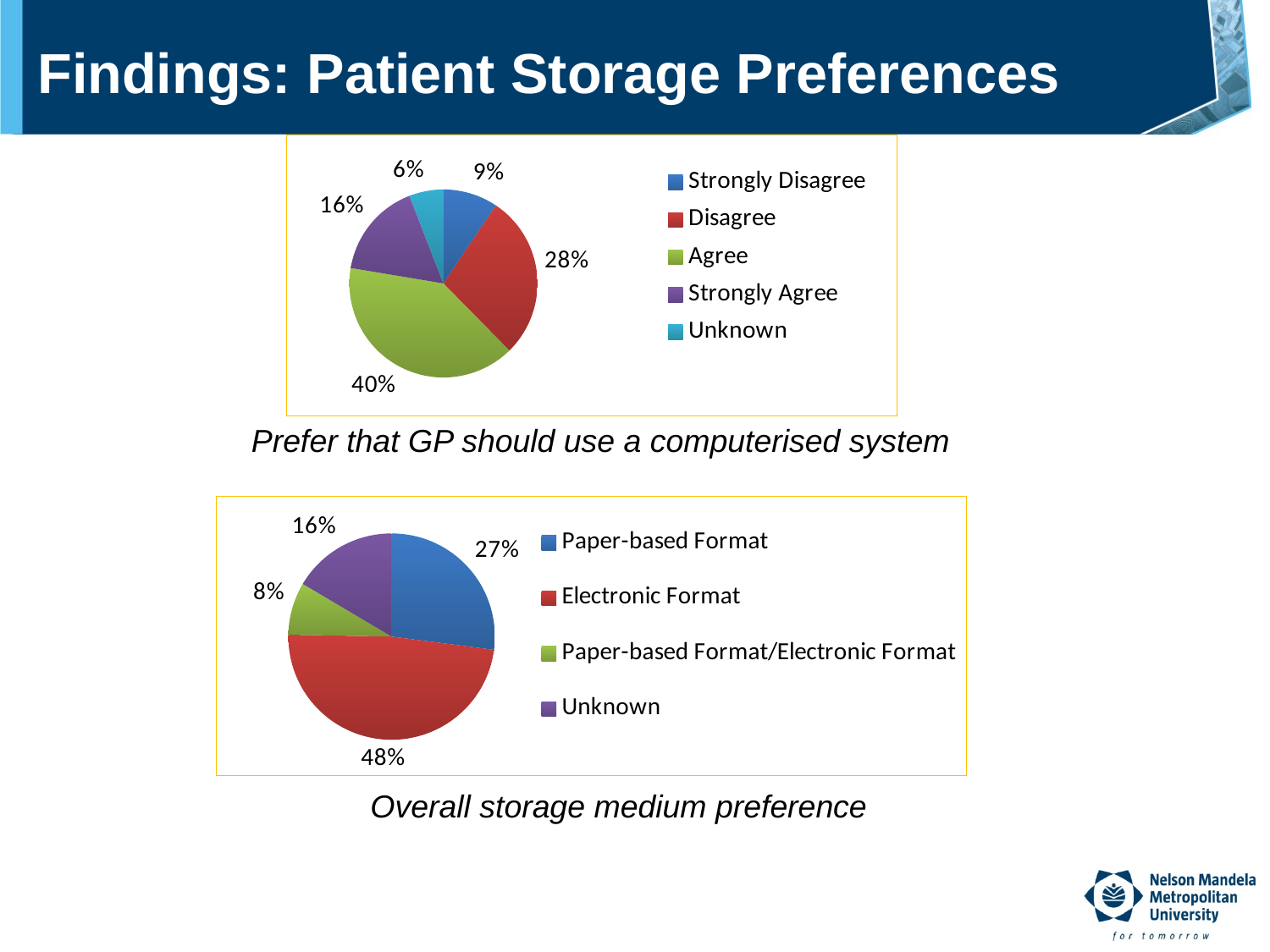
In the bottom chart (Overall storage medium preference), which is larger: Paper-based Format or Unknown? Paper-based Format In the top chart (Prefer that GP should use a computerised system), what is the difference between the Agree and Strongly Agree shares? 24% In the bottom chart (Overall storage medium preference), what share of respondents preferred Paper-based Format/Electronic Format? 8% In the top chart (Prefer that GP should use a computerised system), how many categories does the legend list? 5 In the bottom chart (Overall storage medium preference), what colour represents Electronic Format? Red In the top chart (Prefer that GP should use a computerised system), which category has the smallest share? Unknown In the top chart (Prefer that GP should use a computerised system), what share of respondents chose Agree? 40% What type of chart is used for Overall storage medium preference? Pie chart In the bottom chart (Overall storage medium preference), what share of respondents preferred Electronic Format? 48% In the top chart (Prefer that GP should use a computerised system), what share of respondents chose Disagree? 28% In the bottom chart (Overall storage medium preference), what is the difference between the Electronic Format and Paper-based Format shares? 21% In the top chart (Prefer that GP should use a computerised system), which category has the largest share? Agree